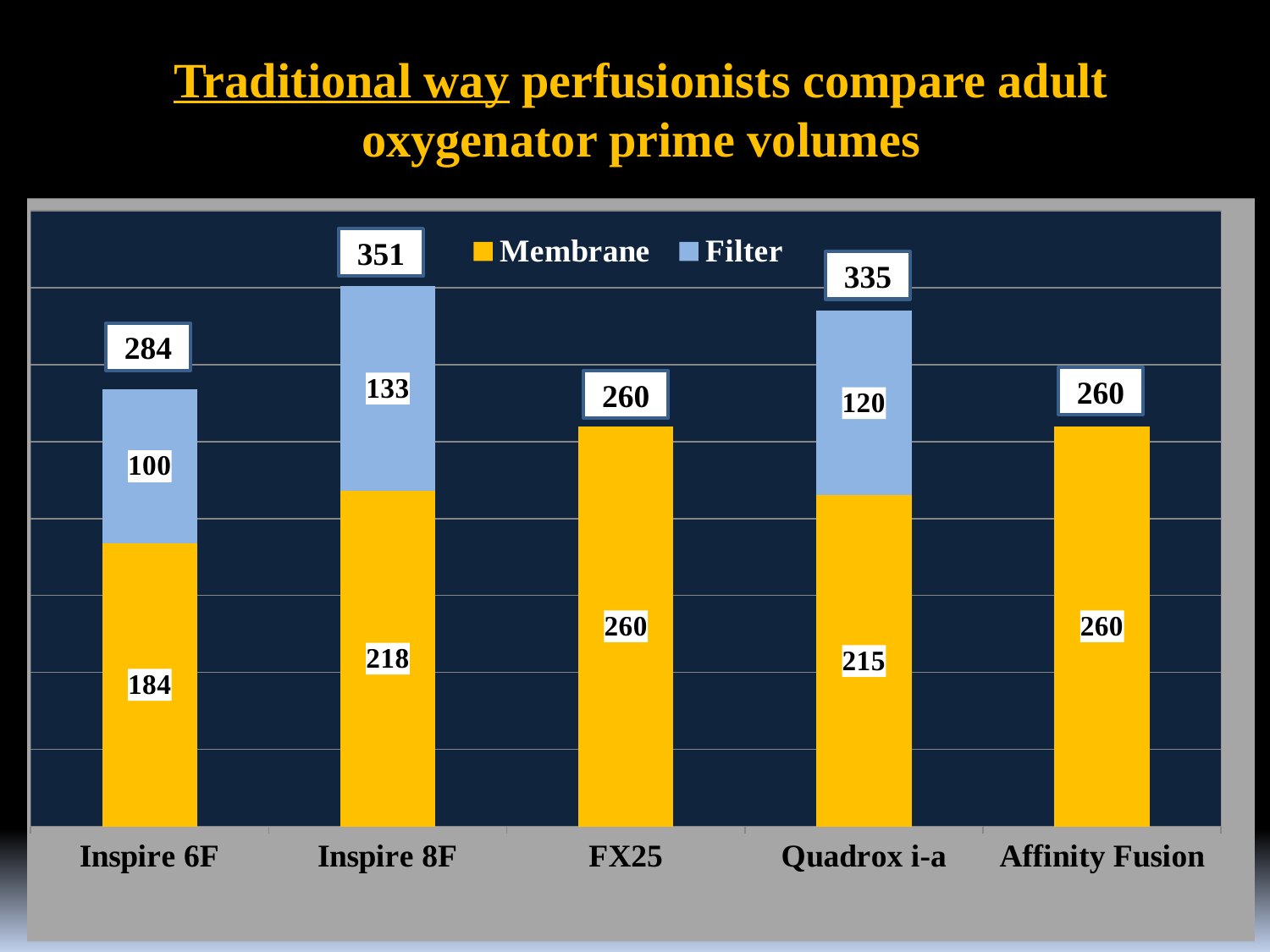
What is the total prime volume shown for Inspire 8F? 351 What is the total prime volume shown for Quadrox i-a? 335 Which oxygenator has the highest total prime volume? Inspire 8F How many series does the legend list? 2 What kind of chart is shown on the slide? Stacked bar chart What is the Filter value for Inspire 8F? 133 Which oxygenator has the lowest Membrane value? Inspire 6F What is the Membrane value for Inspire 6F? 184 What is the Membrane value for Quadrox i-a? 215 What is the difference between the Filter values for Inspire 8F and Inspire 6F? 33 Which is larger, the Membrane value for Inspire 8F or the Membrane value for Quadrox i-a? Inspire 8F How many oxygenators are shown on the x axis? 5